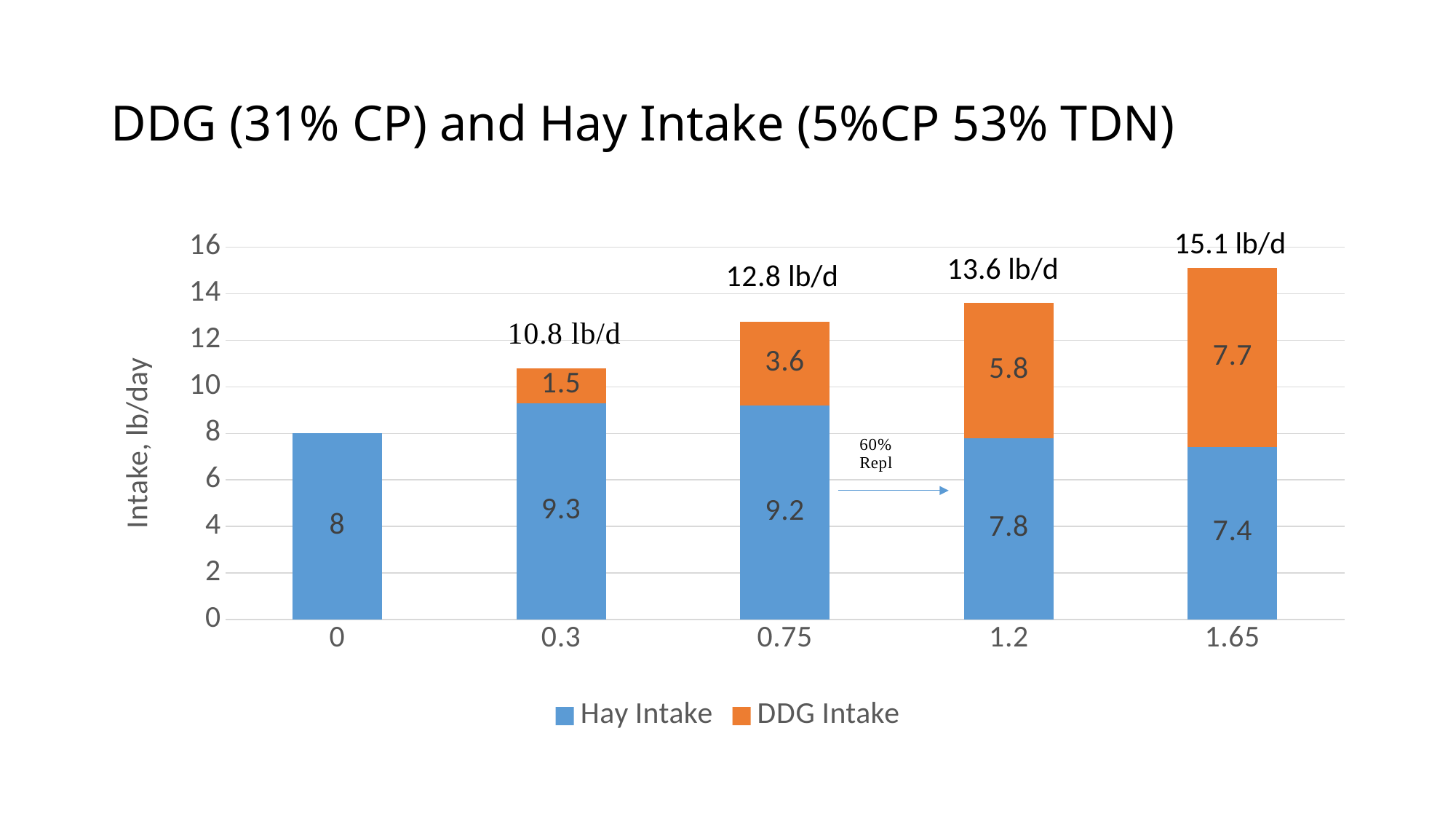
How many series does the legend list? 2 How many categories are shown on the x axis? 5 Which is larger, the Hay Intake at 0.3 or the Hay Intake at 1.2? Hay Intake at 0.3 What kind of chart is shown on the slide? Stacked bar chart What is the difference between the DDG Intake at 1.65 and at 0.75? 4.1 What is the Hay Intake value for the 0.3 category? 9.3 Which category has the highest DDG Intake? 1.65 Which category has the lowest Hay Intake? 1.65 What is the Hay Intake value for the 1.65 category? 7.4 What is the DDG Intake value for the 1.2 category? 5.8 What is the label on the y axis? Intake, lb/day What is the total intake shown above the stacked bar for the 1.2 category? 13.6 lb/d